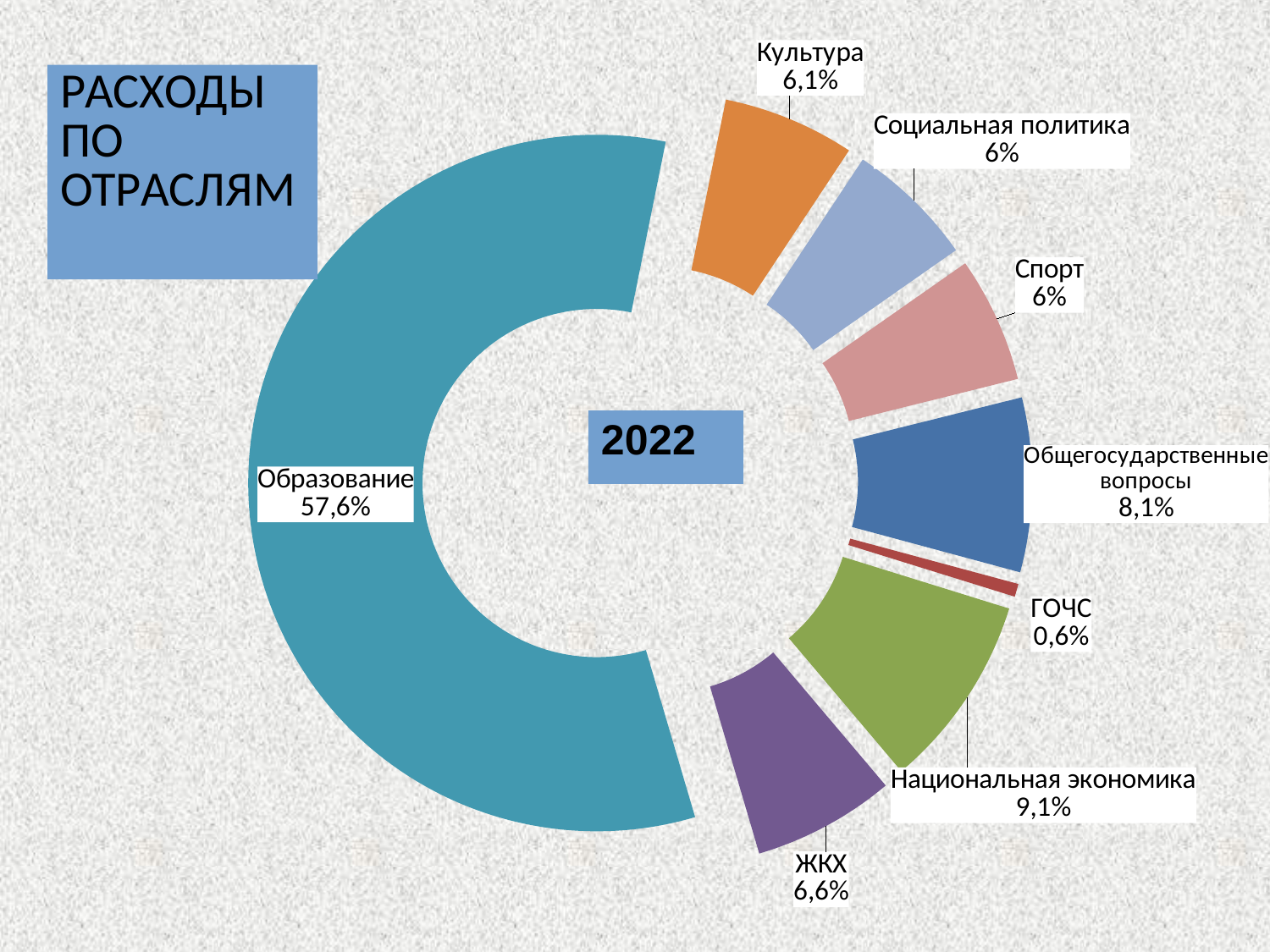
Which is larger, the share for ЖКХ or the share for Культура? ЖКХ What is the value shown for Национальная экономика? 9,1% What share of expenditures does Образование account for? 57,6% How many categories are shown in the chart? 8 What is the value for Общегосударственные вопросы? 8,1% Which category has the largest share of expenditures? Образование What percentage is shown for ГОЧС? 0,6% Which category has the smallest share of expenditures? ГОЧС What is the difference between the shares of Национальная экономика and Общегосударственные вопросы? 1% What year is shown in the centre of the chart? 2022 What kind of chart is shown on the slide? Doughnut (pie) chart What is the difference between the shares of Образование and ЖКХ? 51%